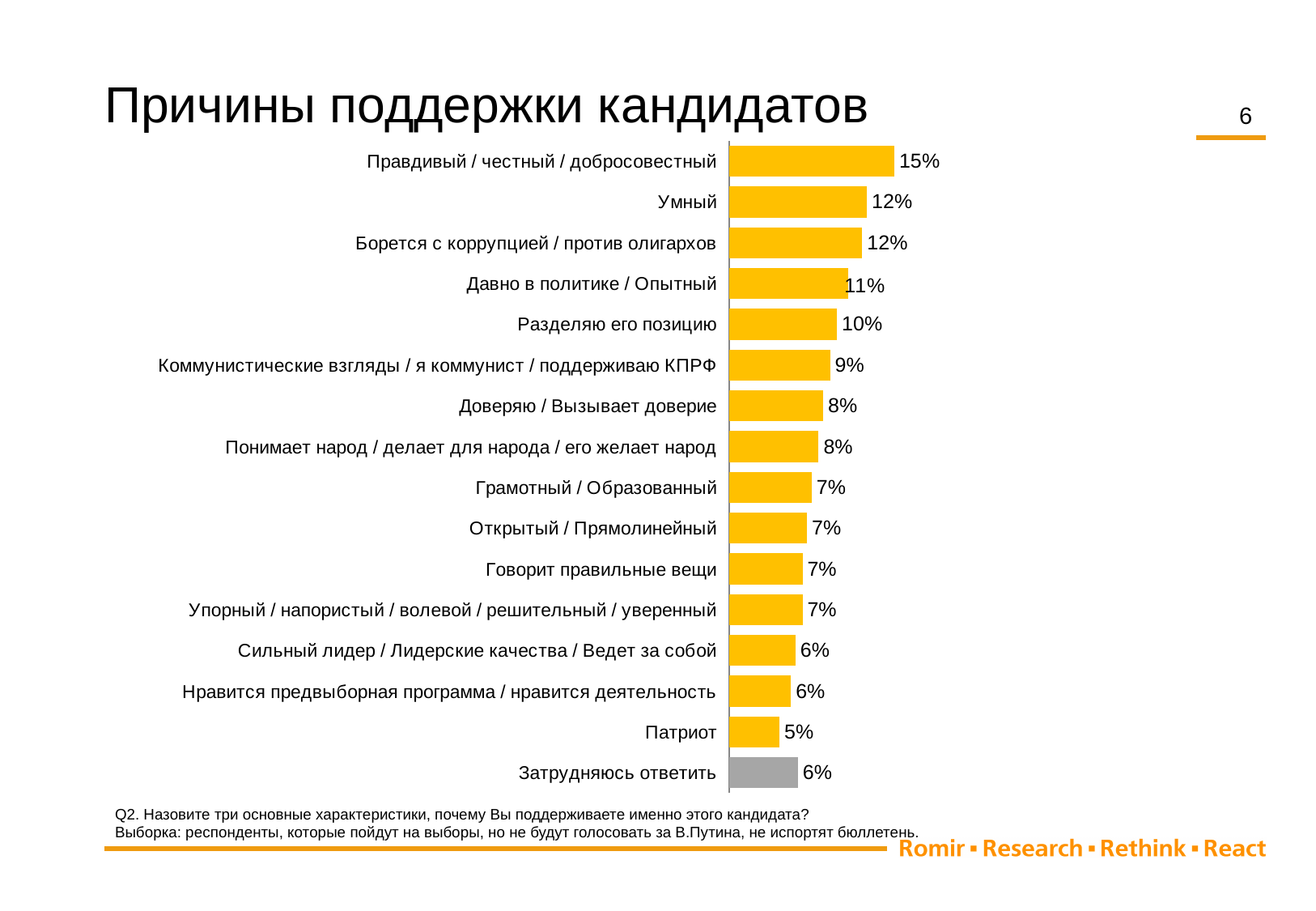
What is the difference between the values for «Правдивый / честный / добросовестный» and «Патриот»? 10 percentage points Which bar is coloured grey instead of yellow? Затрудняюсь ответить What is the title of the slide? Причины поддержки кандидатов What value is shown for «Затрудняюсь ответить»? 6% Which is larger: the value for «Умный» or for «Давно в политике / Опытный»? Умный What kind of chart is shown on the slide? Bar chart What value is shown for «Правдивый / честный / добросовестный»? 15% How many categories are shown in the chart? 16 Which category has the highest value? Правдивый / честный / добросовестный What value is shown for «Патриот»? 5% What value is shown for «Разделяю его позицию»? 10% Which category has the lowest value? Патриот